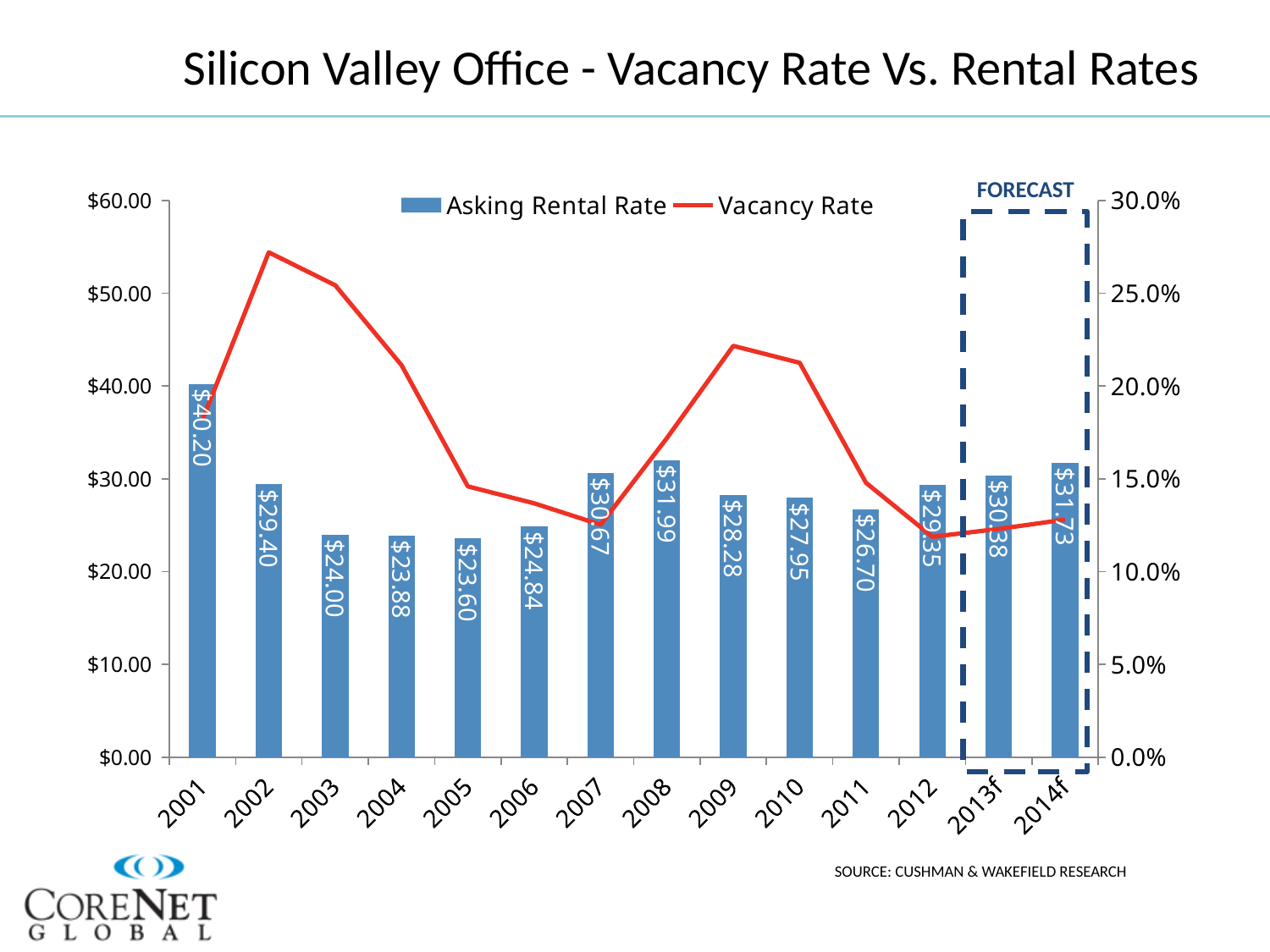
What is the Asking Rental Rate for 2008? $31.99 How many years are shown on the x axis? 14 How many series does the legend list? 2 Does the Vacancy Rate rise or fall from 2009 to 2012? fall What is the Asking Rental Rate for 2001? $40.20 Is the Vacancy Rate for 2002 greater or less than 25.0%? greater Which year has the highest Asking Rental Rate? 2001 What is the difference between the Asking Rental Rate in 2001 and in 2002? $10.80 Which year has the lowest Asking Rental Rate? 2005 Is the Vacancy Rate for 2005 greater or less than 20.0%? less What is the forecast Asking Rental Rate for 2014f? $31.73 Which year has a higher Asking Rental Rate, 2007 or 2012? 2007